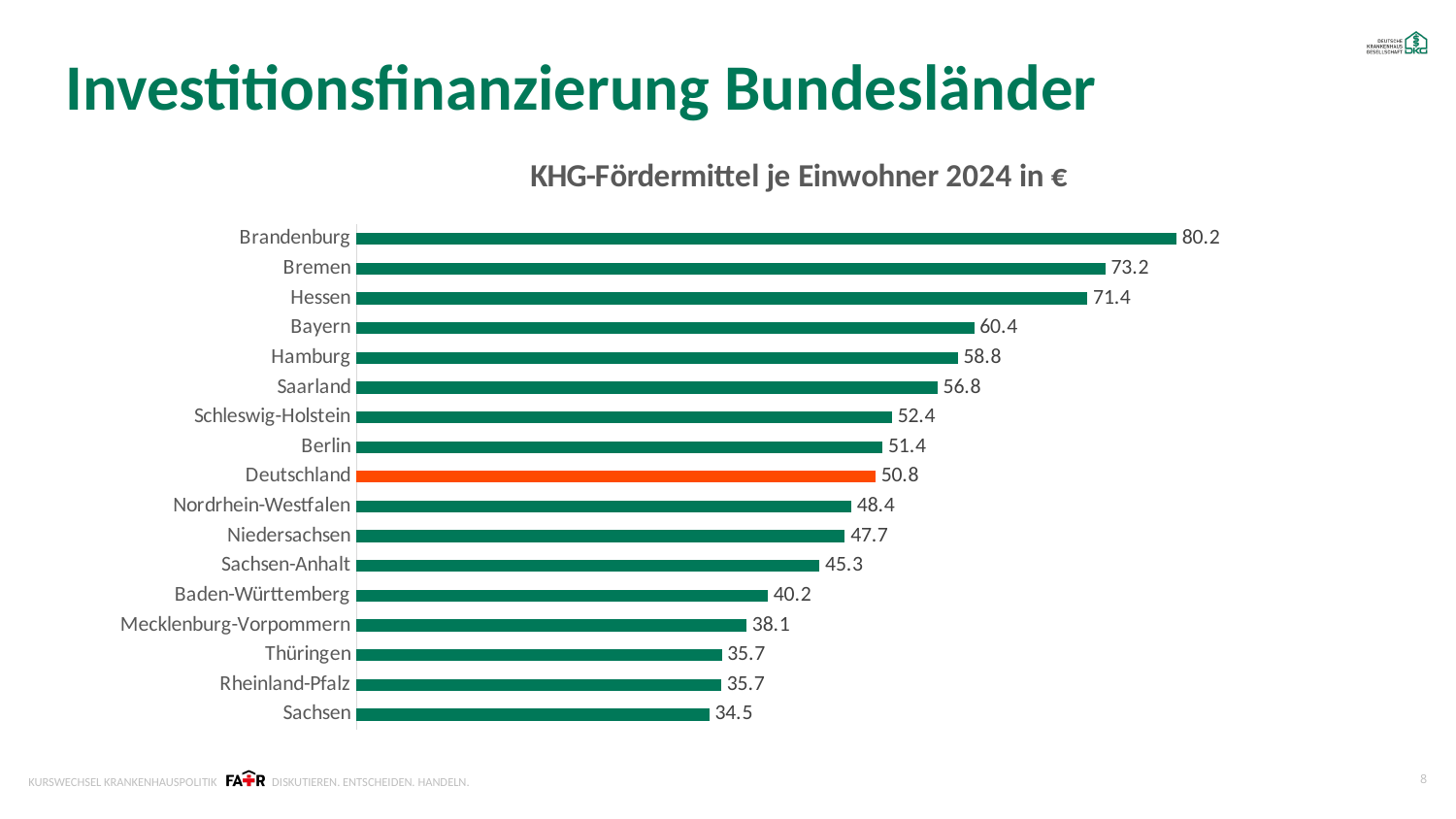
What is the value for Sachsen-Anhalt? 45.3 What kind of chart is shown on the slide? Bar chart Which category has the lowest value? Sachsen Which is larger, the value for Bayern or the value for Hamburg? Bayern What is the value for Deutschland? 50.8 What is the value for Brandenburg? 80.2 Which category has the highest value? Brandenburg What is the difference between the values for Hessen and Deutschland? 20.6 How many categories are shown in the chart? 17 What is the title of the chart? KHG-Fördermittel je Einwohner 2024 in € What is the difference between the values for Brandenburg and Sachsen? 45.7 Which is larger, the value for Niedersachsen or the value for Baden-Württemberg? Niedersachsen